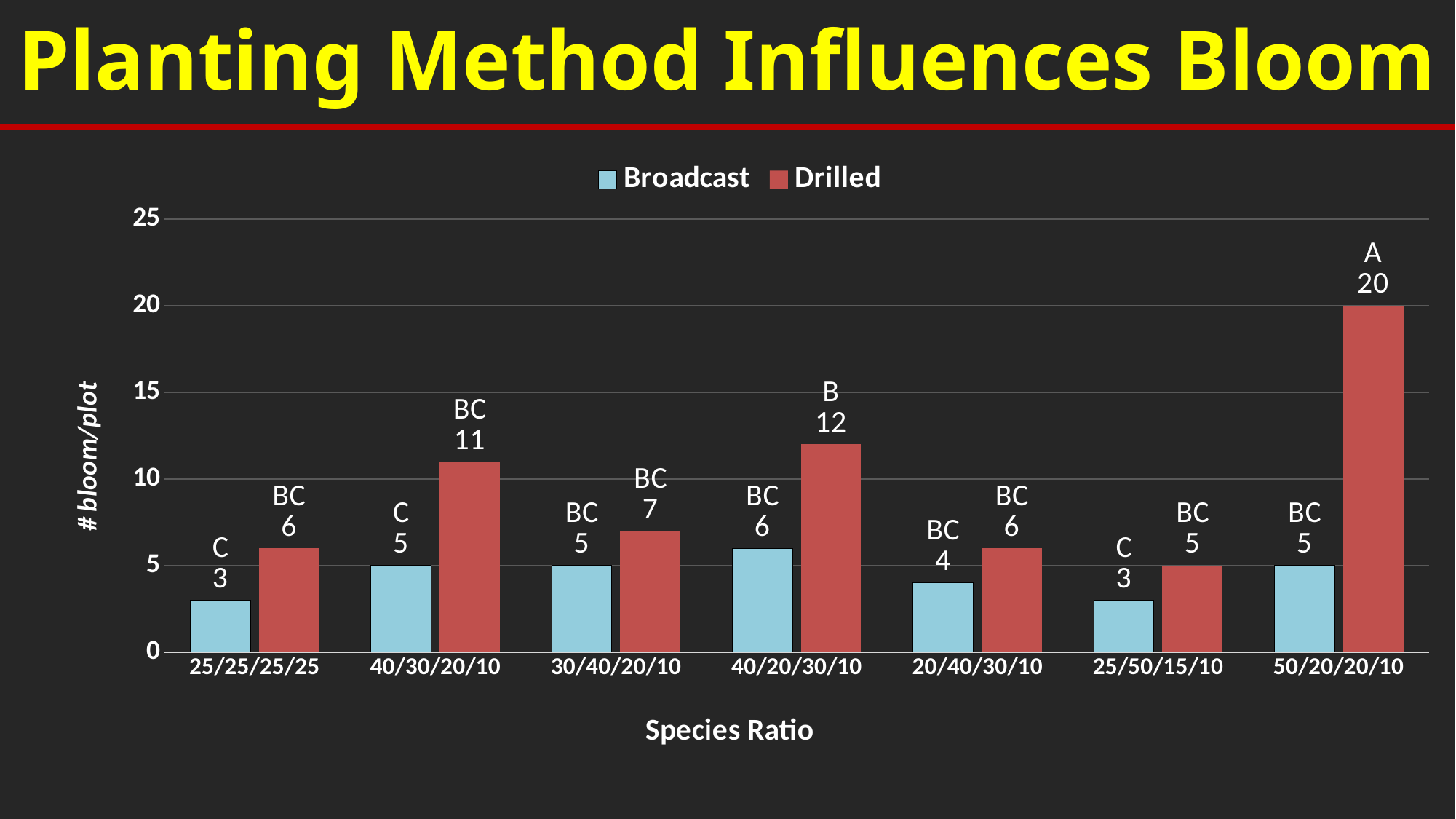
Which species ratio has the highest Drilled value? 50/20/20/10 Which species ratio has the highest Broadcast value? 40/20/30/10 What is the Broadcast value for the 25/25/25/25 species ratio? 3 What is the label of the y axis? # bloom/plot What letter group label is shown above the Drilled bar for 50/20/20/10? A What is the Drilled value for the 50/20/20/10 species ratio? 20 How many species ratios are shown on the x axis? 7 How many series does the legend list? 2 What is the Drilled value for the 40/20/30/10 species ratio? 12 What is the difference between the Drilled and Broadcast values for the 40/30/20/10 species ratio? 6 Which is larger for the 30/40/20/10 species ratio, the Broadcast value or the Drilled value? Drilled What kind of chart is shown on the slide? Bar chart